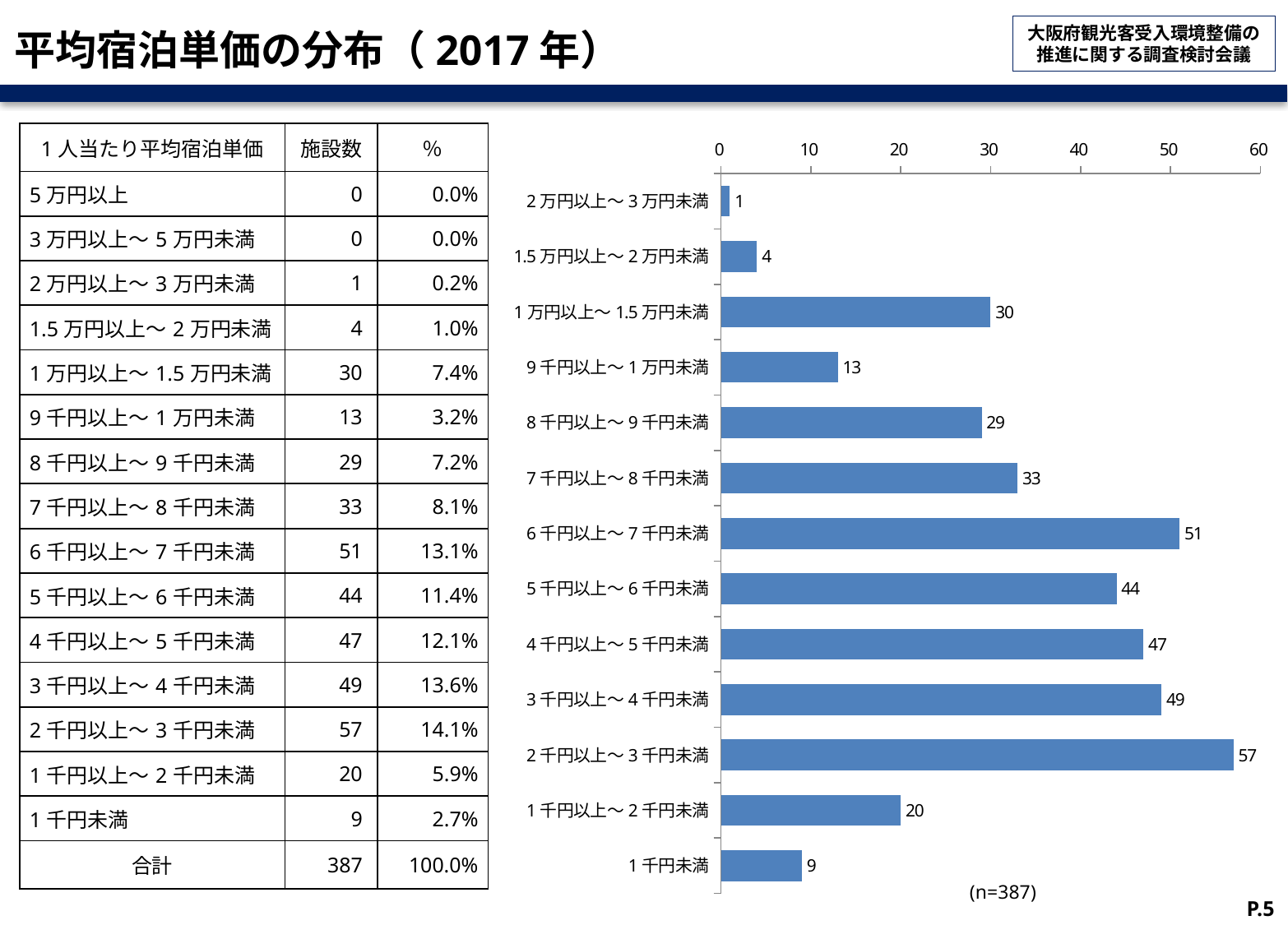
What is the value for 2千円以上～3千円未満 in the bar chart? 57 What is the value for 1万円以上～1.5万円未満 in the bar chart? 30 What sample size (n) is noted below the chart? n=387 Which category has the highest value in the bar chart? 2千円以上～3千円未満 What kind of chart is shown on the slide? bar chart Which is larger, the value for 8千円以上～9千円未満 or the value for 7千円以上～8千円未満? 7千円以上～8千円未満 Is the value for 4千円以上～5千円未満 greater or less than 40? greater What is the maximum value shown on the chart's value axis? 60 How many categories are plotted in the bar chart? 13 What is the difference between the values for 6千円以上～7千円未満 and 5千円以上～6千円未満? 7 Which category has the lowest value in the bar chart? 2万円以上～3万円未満 What is the value for 1千円未満 in the bar chart? 9